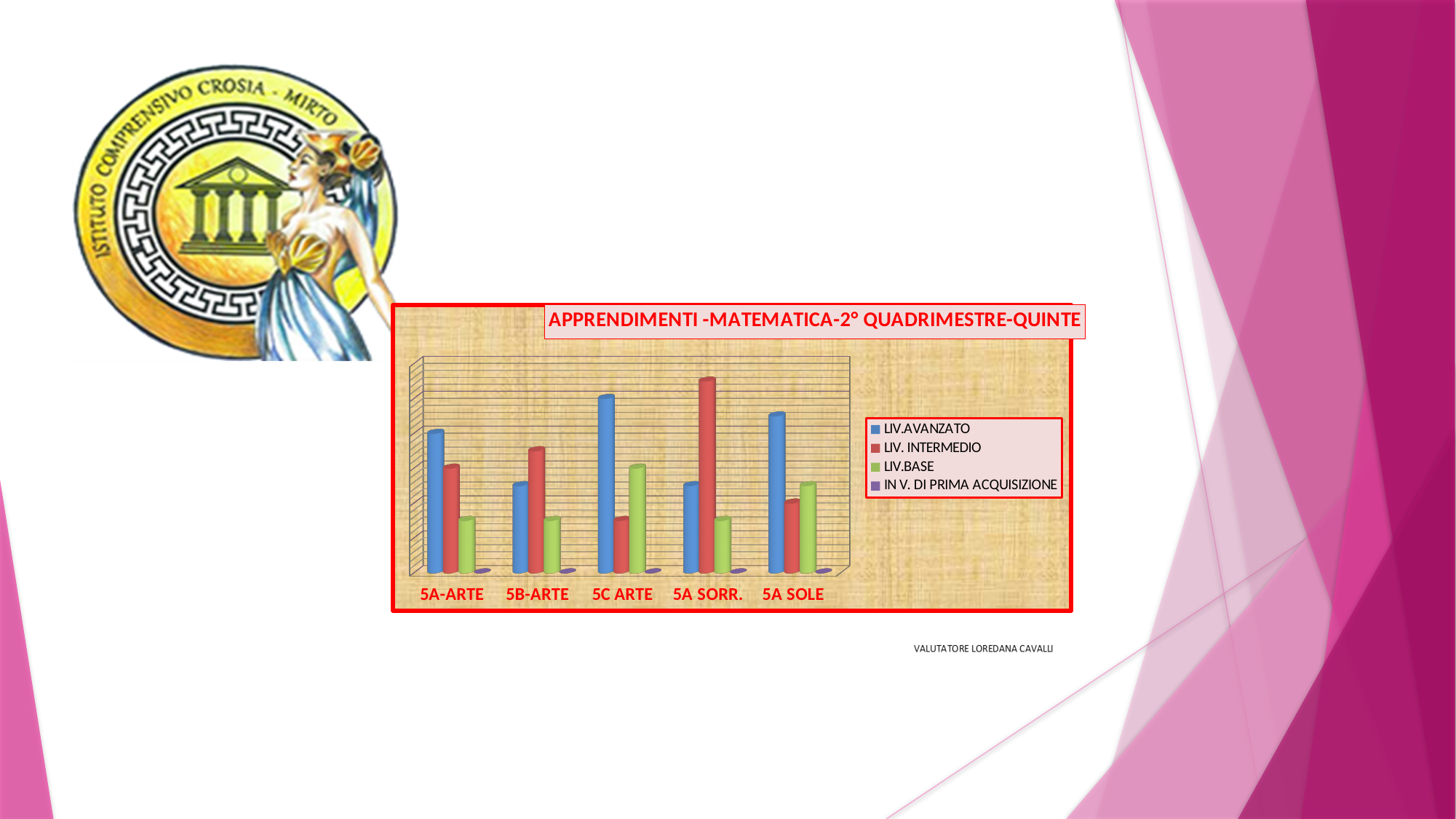
How many series does the chart legend list? 4 For 5A SORR., which is larger: LIV.AVANZATO or LIV. INTERMEDIO? LIV. INTERMEDIO Which class has the highest LIV. INTERMEDIO bar? 5A SORR. Which colour represents LIV.BASE in the chart legend? green Which class has the highest LIV.AVANZATO bar? 5C ARTE For 5C ARTE, which is larger: LIV.BASE or LIV. INTERMEDIO? LIV.BASE Which class has the highest LIV.BASE bar? 5C ARTE For 5A-ARTE, which is larger: LIV.AVANZATO or LIV. INTERMEDIO? LIV.AVANZATO What kind of chart is shown on the slide? bar chart What is the title of the chart? APPRENDIMENTI -MATEMATICA-2° QUADRIMESTRE-QUINTE How many classes (categories) are shown on the x axis of the chart? 5 Which series has the lowest bar for every class in the chart? IN V. DI PRIMA ACQUISIZIONE